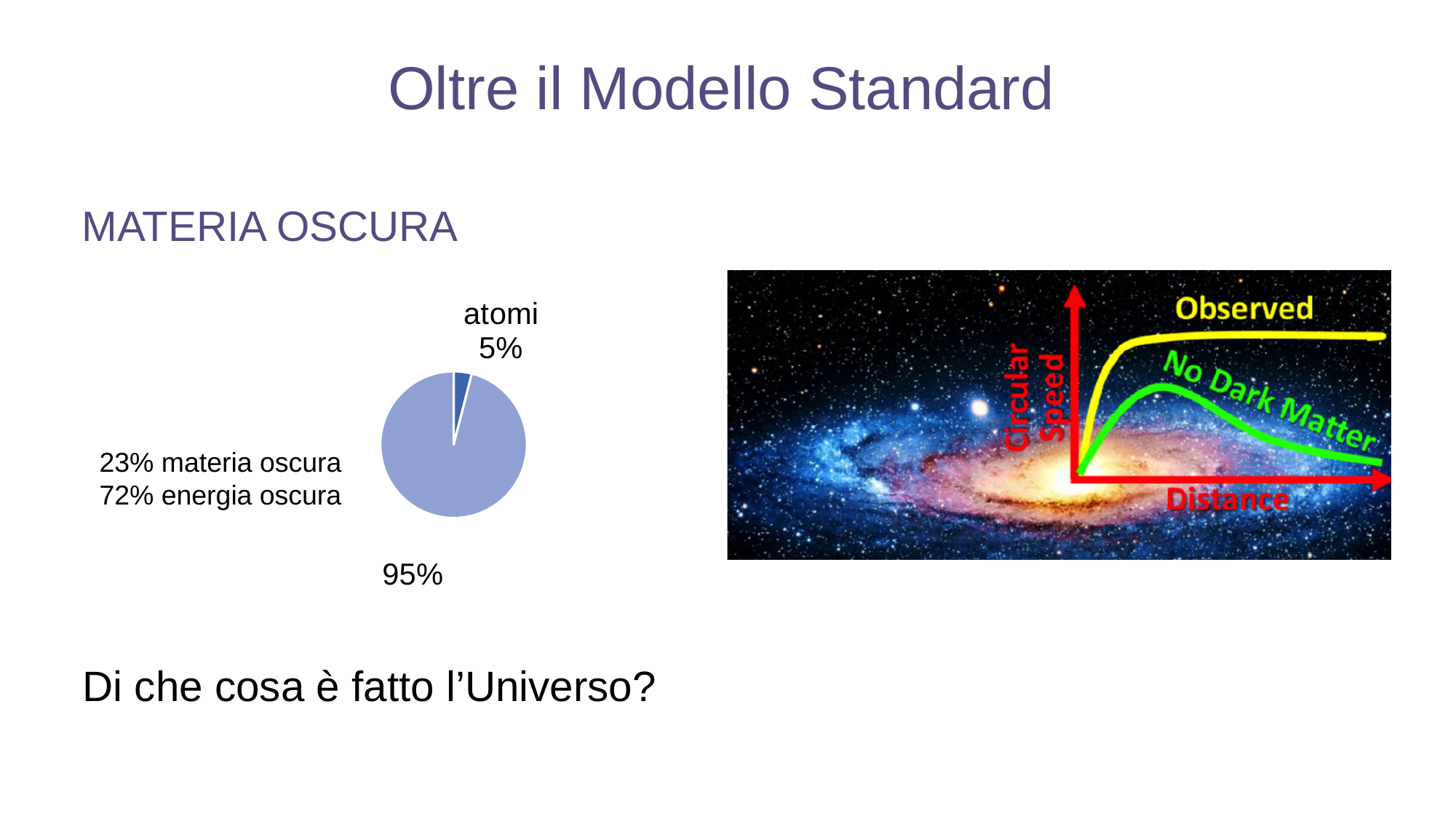
Which slice of the pie chart is the smallest? atomi In the pie chart, what percentage is printed for the larger slice? 95% What is the difference between the 95% slice and the atomi slice in the pie chart? 90% In the pie chart, what share is labelled for atomi? 5% In the pie chart, which is larger: the atomi slice or the other slice? the other slice (95%) What kind of chart is shown under the heading MATERIA OSCURA? pie chart What colour is the atomi slice in the pie chart? dark blue What is the percentage of the largest slice in the pie chart? 95% What share of the pie does the atomi slice represent? 5% In the galaxy diagram on the right, what are the two curves labelled? Observed and No Dark Matter What do the two slices of the pie chart add up to? 100% How many slices does the pie chart have? 2